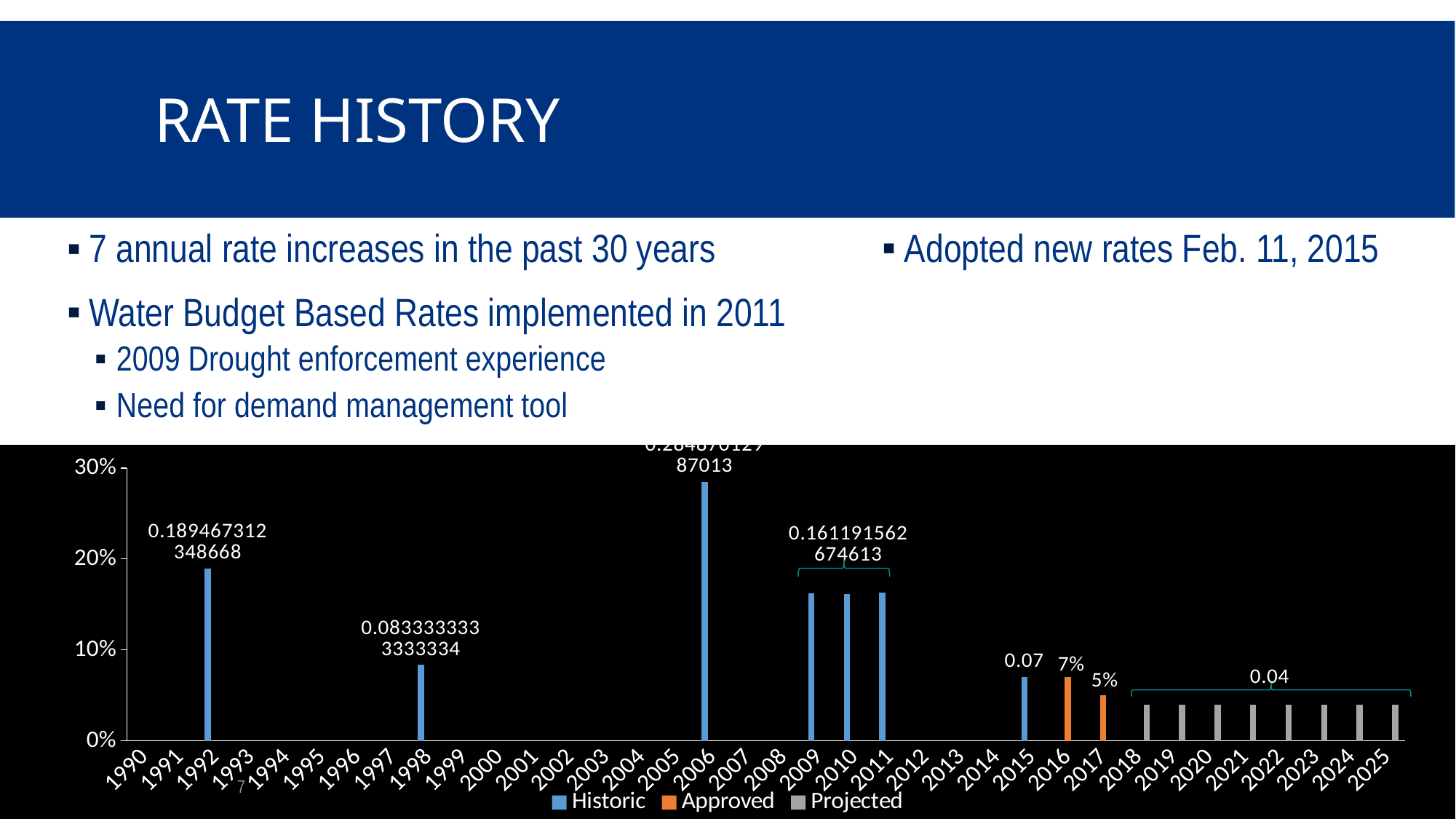
What is the value shown for 2017? 5% How many years are shown with Projected (gray) bars? 8 Which year has the highest bar in the chart? 2006 What is the value shown for 2016? 7% What are the three series named in the chart legend? Historic, Approved, Projected How many series does the chart legend list? 3 What is the difference between the 2016 value and the 2017 value? 2% What type of chart is shown on the slide? bar chart Which is larger, the value for 2016 or the value for 2017? 2016 What value is labelled for the projected bars from 2018 to 2025? 0.04 What is the value shown for 2015? 0.07 Is the value for 1992 greater or less than 10%? greater